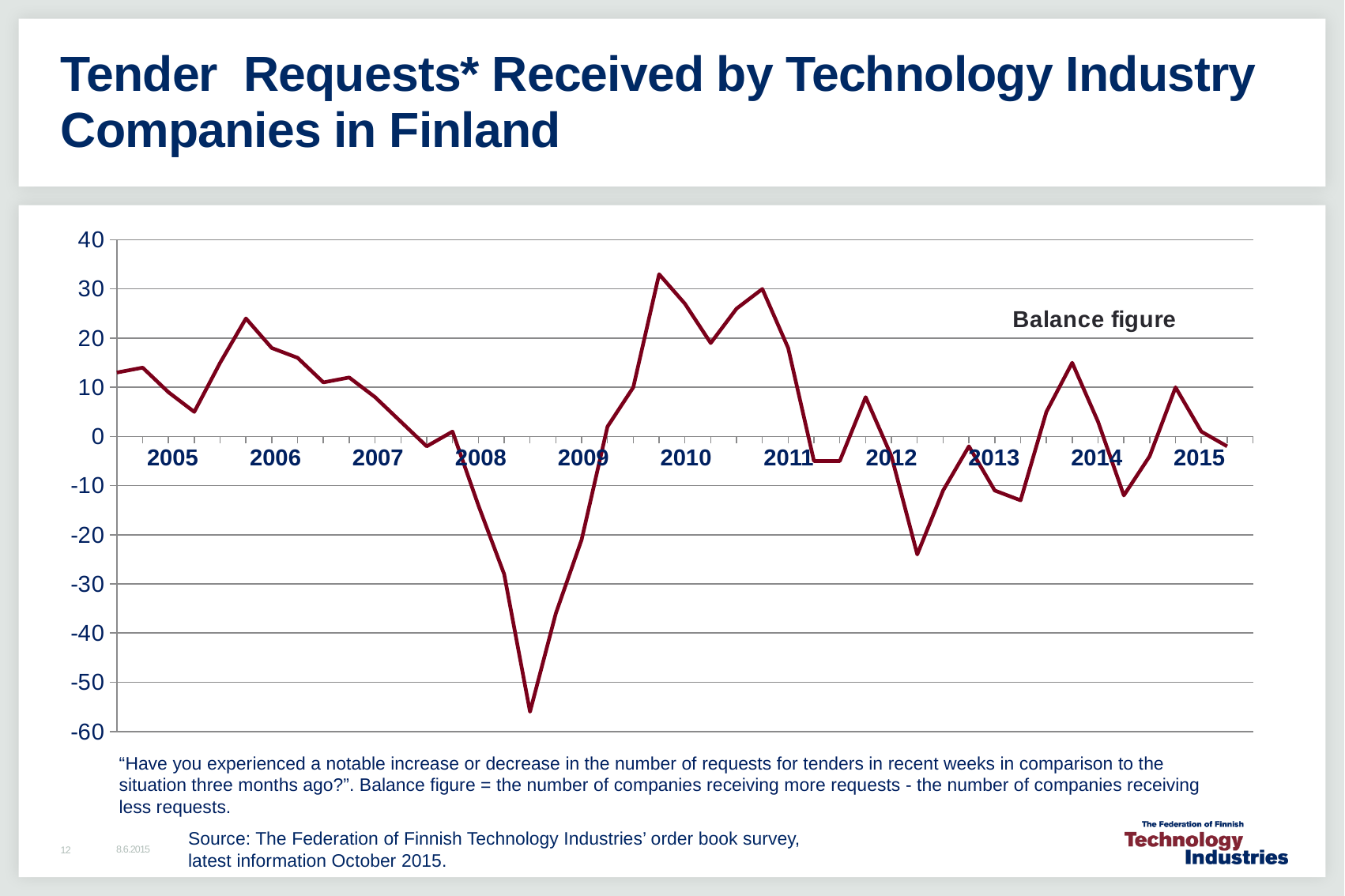
Does the balance figure rise or fall from the start of 2008 to its lowest point? fall Does the balance figure rise or fall from its lowest point to its highest point? rise Is the peak of the line during 2014 greater or less than 10? greater What is the label of the series plotted on the chart? Balance figure Is the lowest point of the balance figure line greater or less than -50? less Is the highest point of the balance figure line greater or less than 30? greater What kind of chart is shown on the slide? Line chart How many year labels appear along the x axis of the chart? 11 Which is larger: the lowest point of the line in 2012 or the lowest point of the line in 2013? 2013 What is the highest value shown on the y axis of the chart? 40